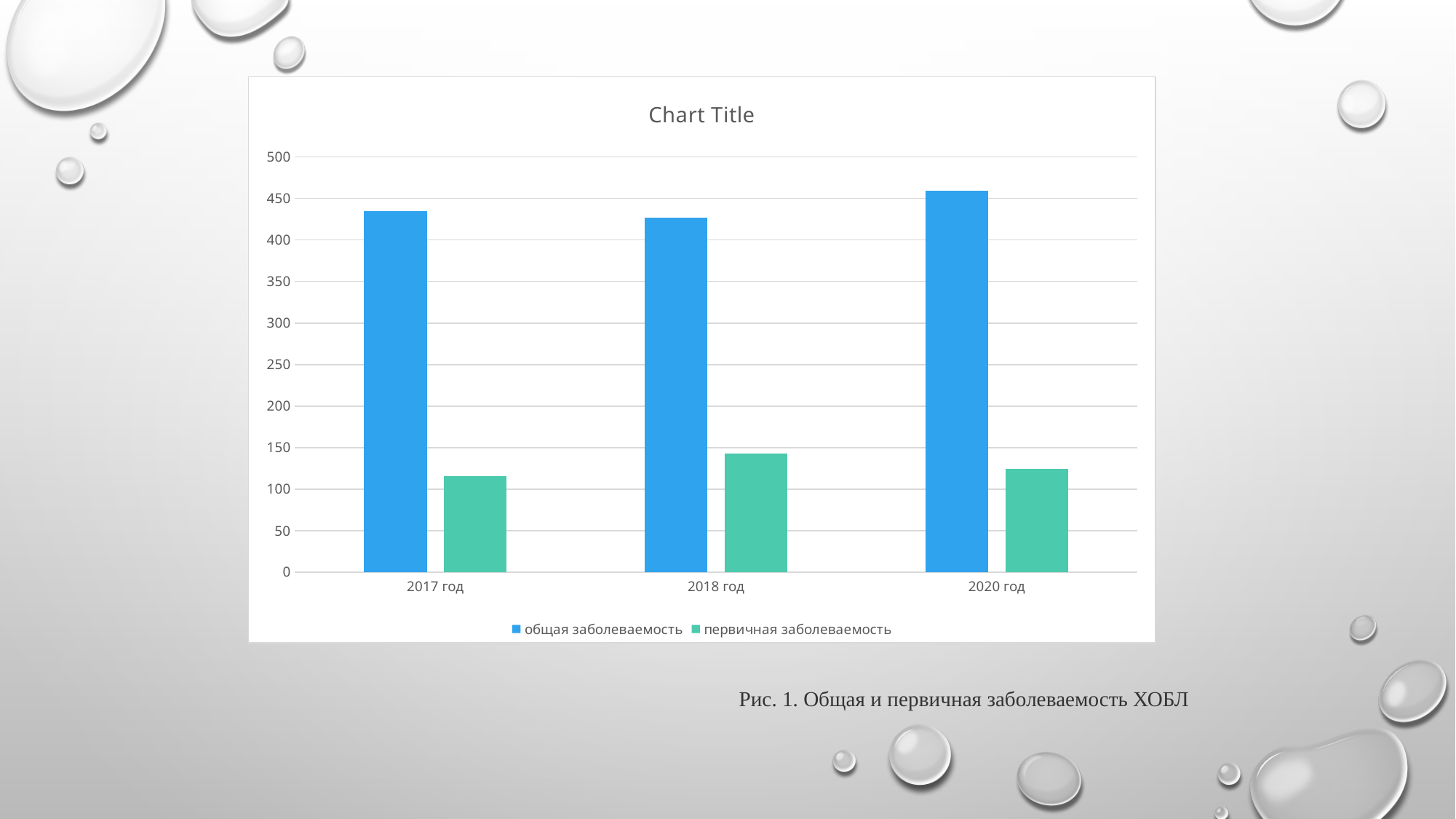
In 2018 год, which is larger: общая заболеваемость or первичная заболеваемость? общая заболеваемость In which year is общая заболеваемость highest? 2020 год Is the value for общая заболеваемость in 2017 год greater or less than 400? greater In which year is первичная заболеваемость highest? 2018 год Is the value for первичная заболеваемость in 2017 год greater or less than 100? greater What is the title shown above the chart? Chart Title Which series is shown in green in the legend? первичная заболеваемость Is the value for первичная заболеваемость in 2018 год greater or less than 150? less How many series does the legend list? 2 What kind of chart is shown on the slide? bar chart How many year categories are shown on the x axis? 3